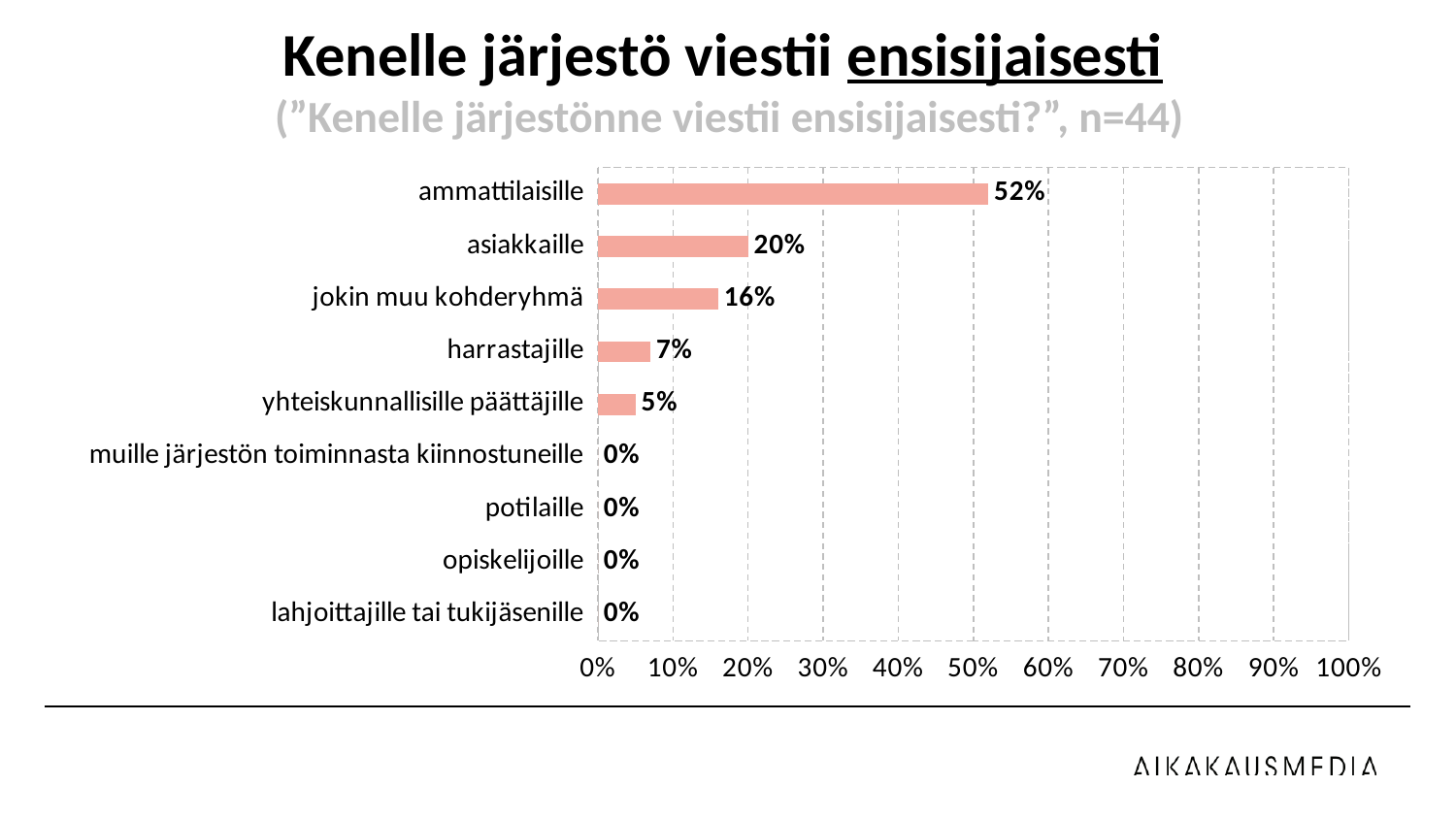
What is the value for yhteiskunnallisille päättäjille? 5% What is the value for ammattilaisille? 52% Which is larger, the value for harrastajille or the value for yhteiskunnallisille päättäjille? harrastajille What is the difference between the values for ammattilaisille and asiakkaille? 32 percentage points Which category has the highest value? ammattilaisille What kind of chart is shown on the slide? bar chart Is the value for ammattilaisille greater or less than 50%? greater What is the value for asiakkaille? 20% What is the value for jokin muu kohderyhmä? 16% How many categories have a value of 0%? 4 What is the sample size (n) given in the chart subtitle? n=44 How many categories are shown in the chart? 9